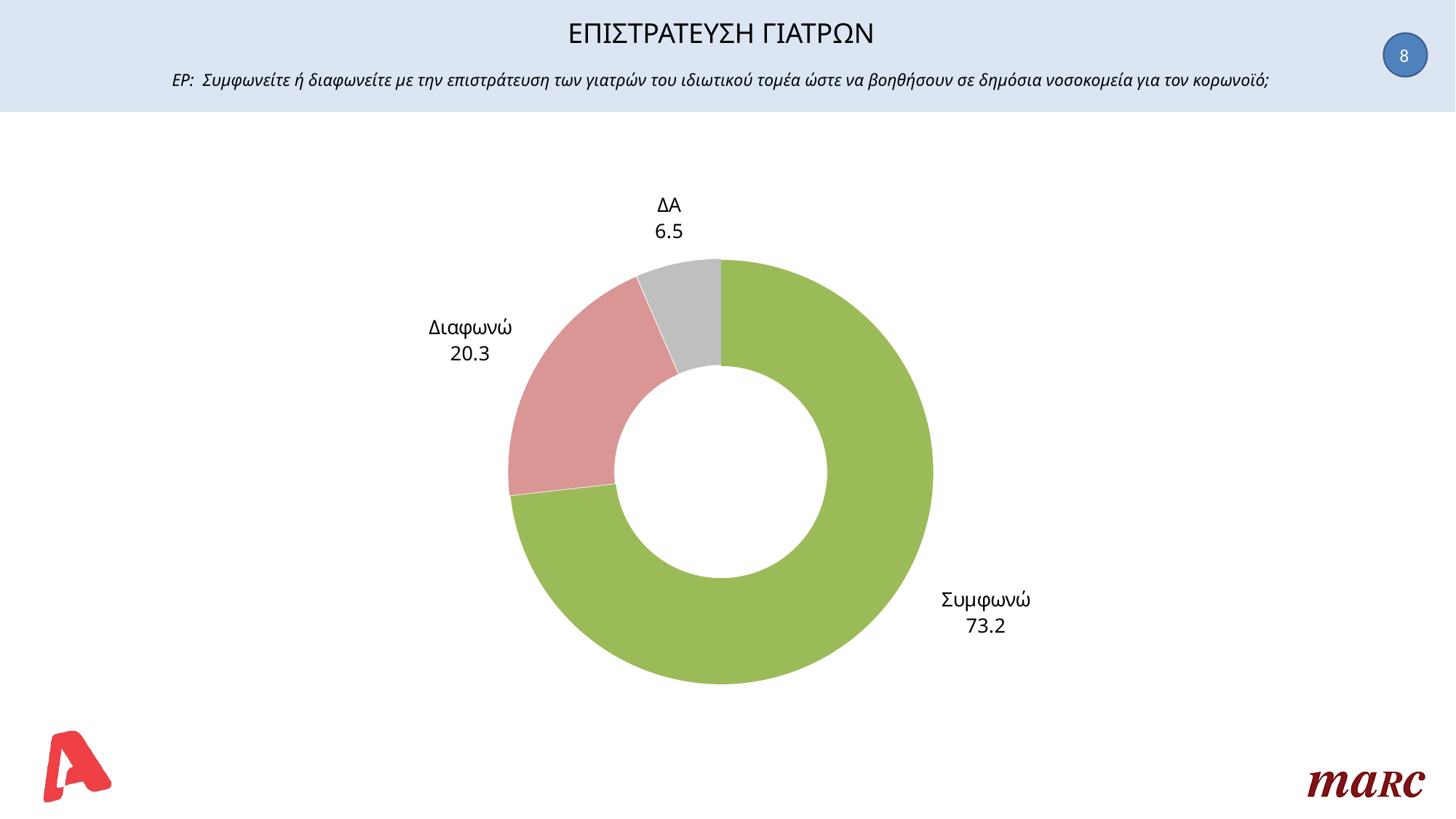
Which category has the largest slice? Συμφωνώ What value is shown for Συμφωνώ? 73.2 What is the difference between the values for Διαφωνώ and ΔΑ? 13.8 What is the difference between the values for Συμφωνώ and Διαφωνώ? 52.9 What is the title of the slide? ΕΠΙΣΤΡΑΤΕΥΣΗ ΓΙΑΤΡΩΝ What value is shown for ΔΑ? 6.5 What kind of chart is shown on the slide? Pie chart (doughnut) What colour is the slice for Συμφωνώ? Green What value is shown for Διαφωνώ? 20.3 Which is larger, the value for Διαφωνώ or the value for ΔΑ? Διαφωνώ Which category has the smallest slice? ΔΑ How many categories does the chart show? 3